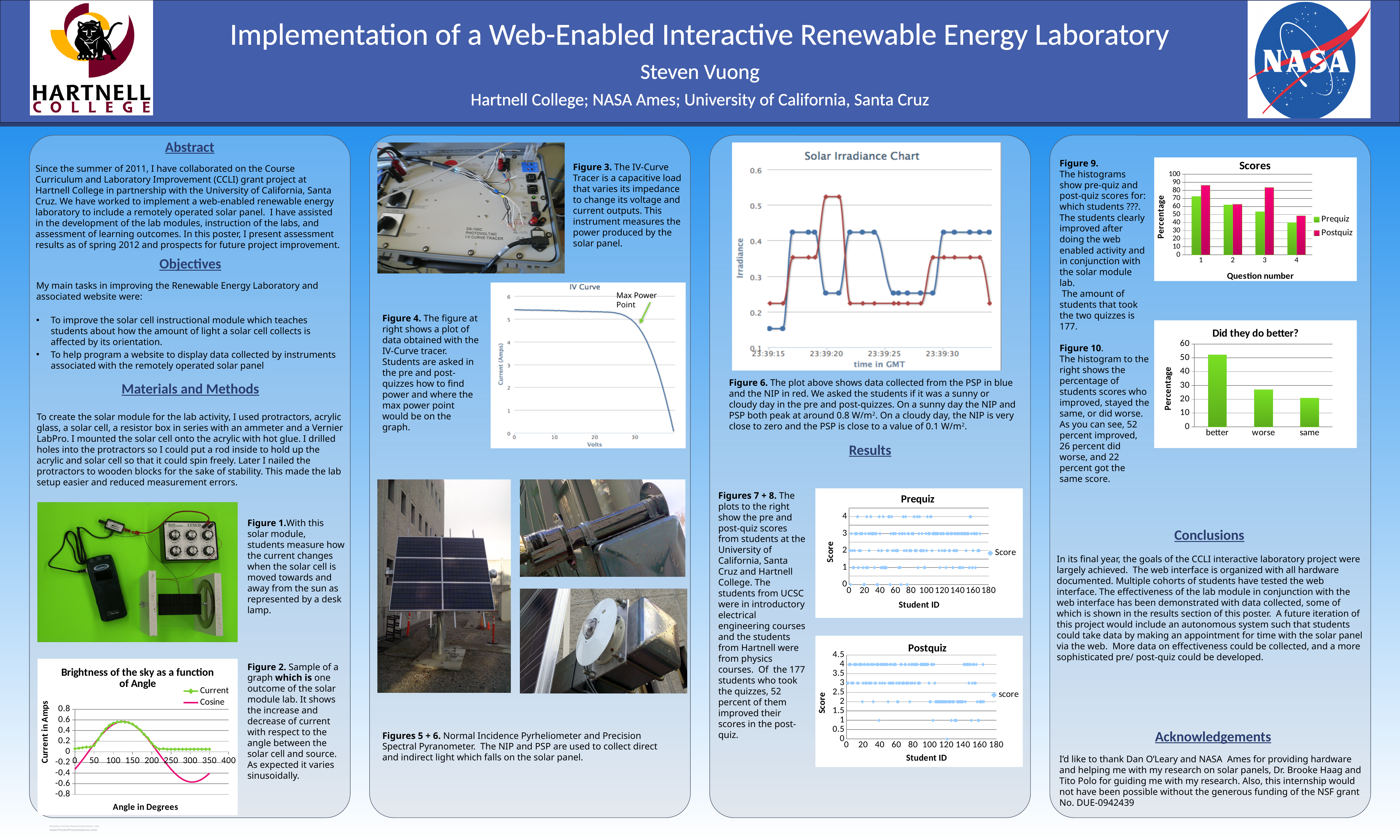
In the 'Scores' chart, for question 3, which is larger: the Prequiz or the Postquiz percentage? Postquiz In the 'Did they do better?' chart, which category has the lowest percentage? same In the 'Scores' chart, is the Prequiz value for question 4 greater or less than 50? less In the 'Scores' chart, which question number has the lowest Prequiz percentage? 4 What kind of chart is 'Did they do better?' bar chart In the 'Did they do better?' chart, is the value for 'worse' greater or less than 30? less In the 'Scores' chart, is the Postquiz value for question 1 greater or less than 80? greater In the 'Did they do better?' chart, which category has the highest percentage? better In the 'Scores' chart, how many question numbers are shown on the x axis? 4 What is the x-axis label of the 'Solar Irradiance Chart'? time in GMT In the 'Brightness of the sky as a function of Angle' chart, how many series does the legend list? 2 In the 'Scores' chart, how many series does the legend list? 2